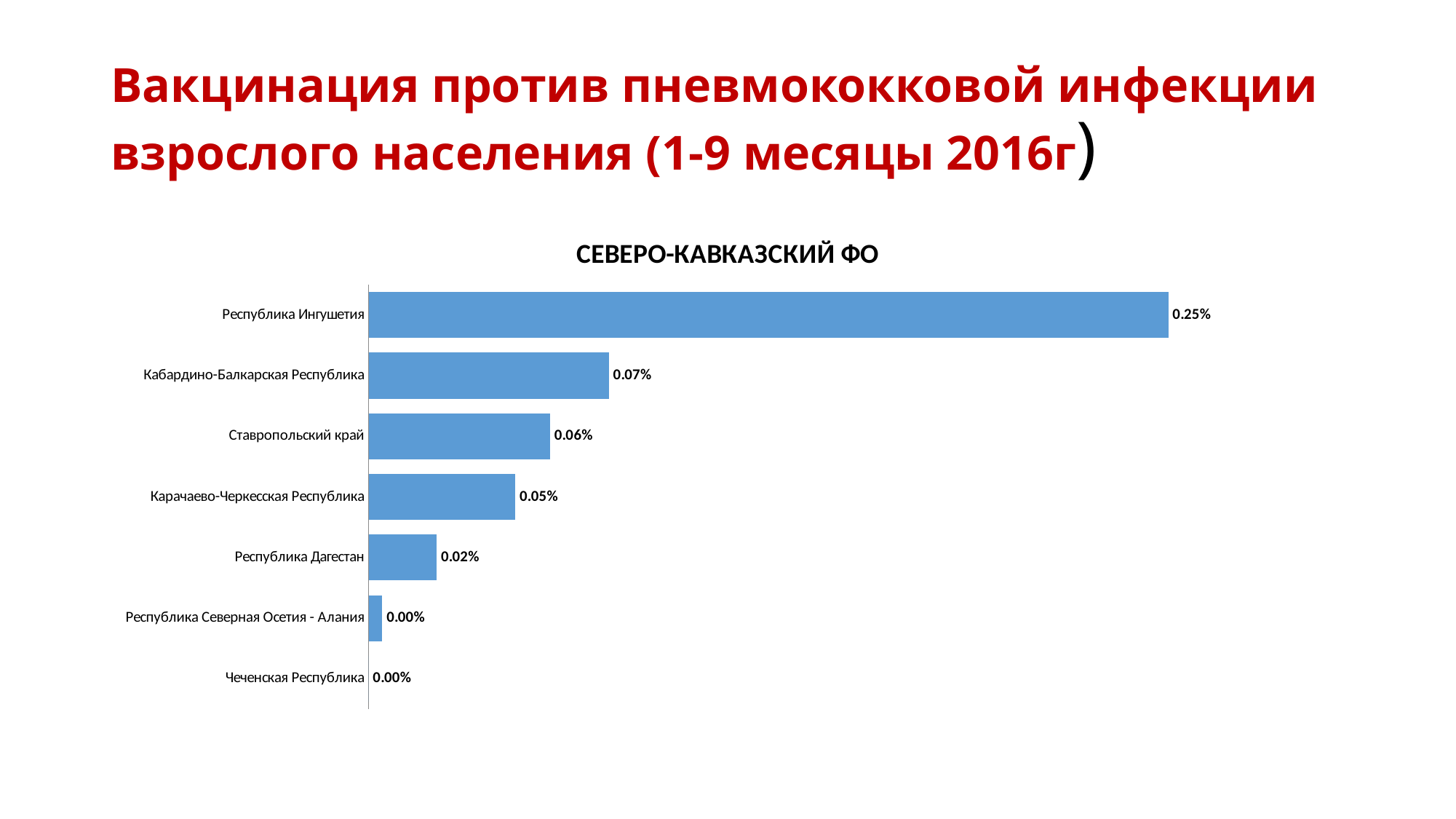
What is the title of the chart? СЕВЕРО-КАВКАЗСКИЙ ФО Which region has the highest value? Республика Ингушетия What is the difference between the values for Республика Ингушетия and Кабардино-Балкарская Республика? 0.18% What is the value for Республика Дагестан? 0.02% What is the value for Кабардино-Балкарская Республика? 0.07% What is the value labelled for Чеченская Республика? 0.00% What is the value for Республика Ингушетия? 0.25% What kind of chart is shown on the slide? Bar chart What is the difference between the values for Карачаево-Черкесская Республика and Республика Дагестан? 0.03% What is the value for Ставропольский край? 0.06% Which is larger, the value for Ставропольский край or the value for Карачаево-Черкесская Республика? Ставропольский край How many regions are shown in the chart? 7